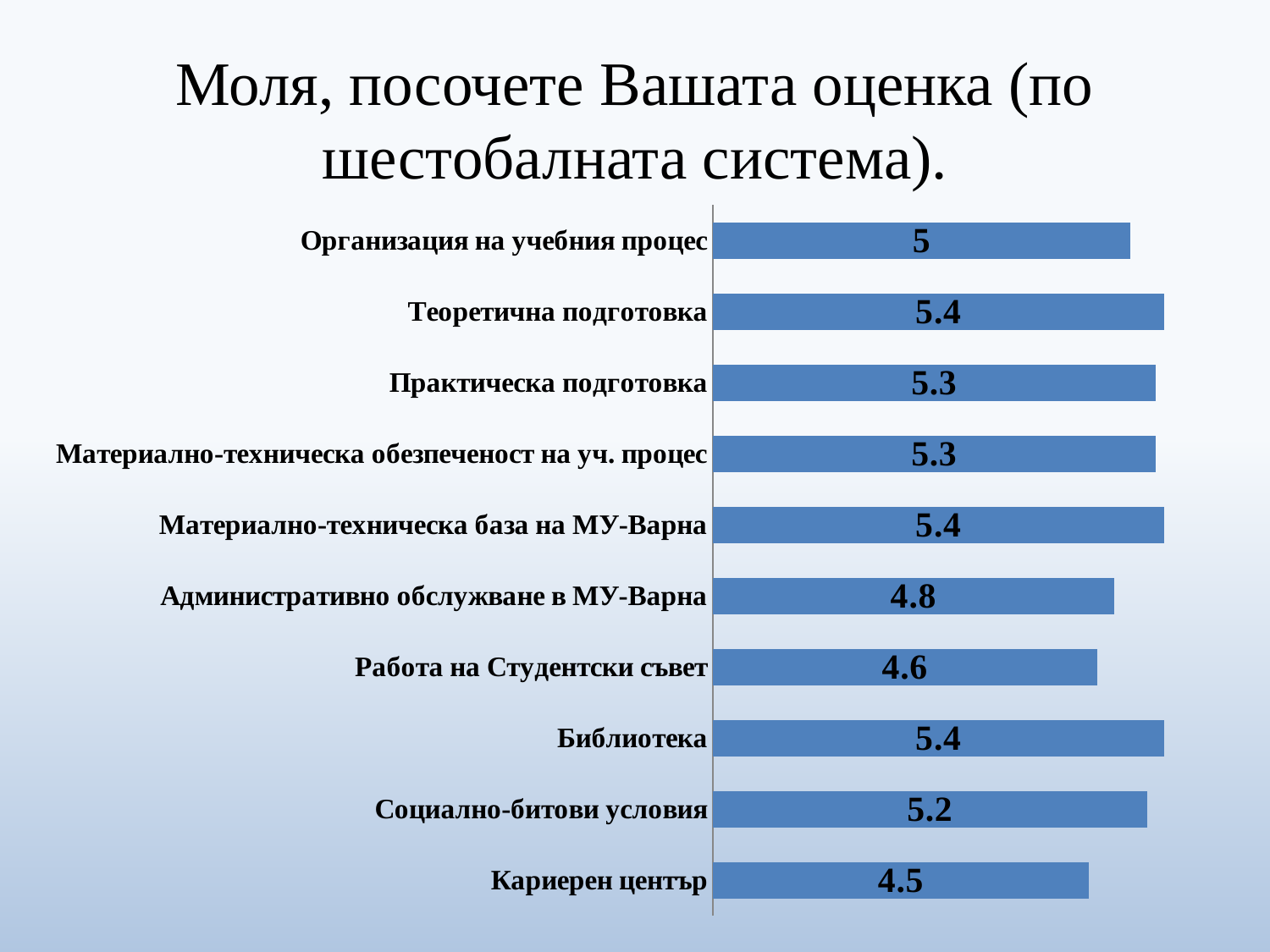
What kind of chart is shown on the slide? bar chart What is the difference between the values for Практическа подготовка and Работа на Студентски съвет? 0.7 What is the value for Социално-битови условия? 5.2 How many categories are plotted in the chart? 10 What is the value for Организация на учебния процес? 5 What is the value for Работа на Студентски съвет? 4.6 Which is larger, the value for Административно обслужване в МУ-Варна or the value for Кариерен център? Административно обслужване в МУ-Варна What is the highest value shown in the chart? 5.4 Which is larger, the value for Библиотека or the value for Социално-битови условия? Библиотека What is the value for Административно обслужване в МУ-Варна? 4.8 Which category has the lowest value? Кариерен център What is the difference between the values for Теоретична подготовка and Кариерен център? 0.9